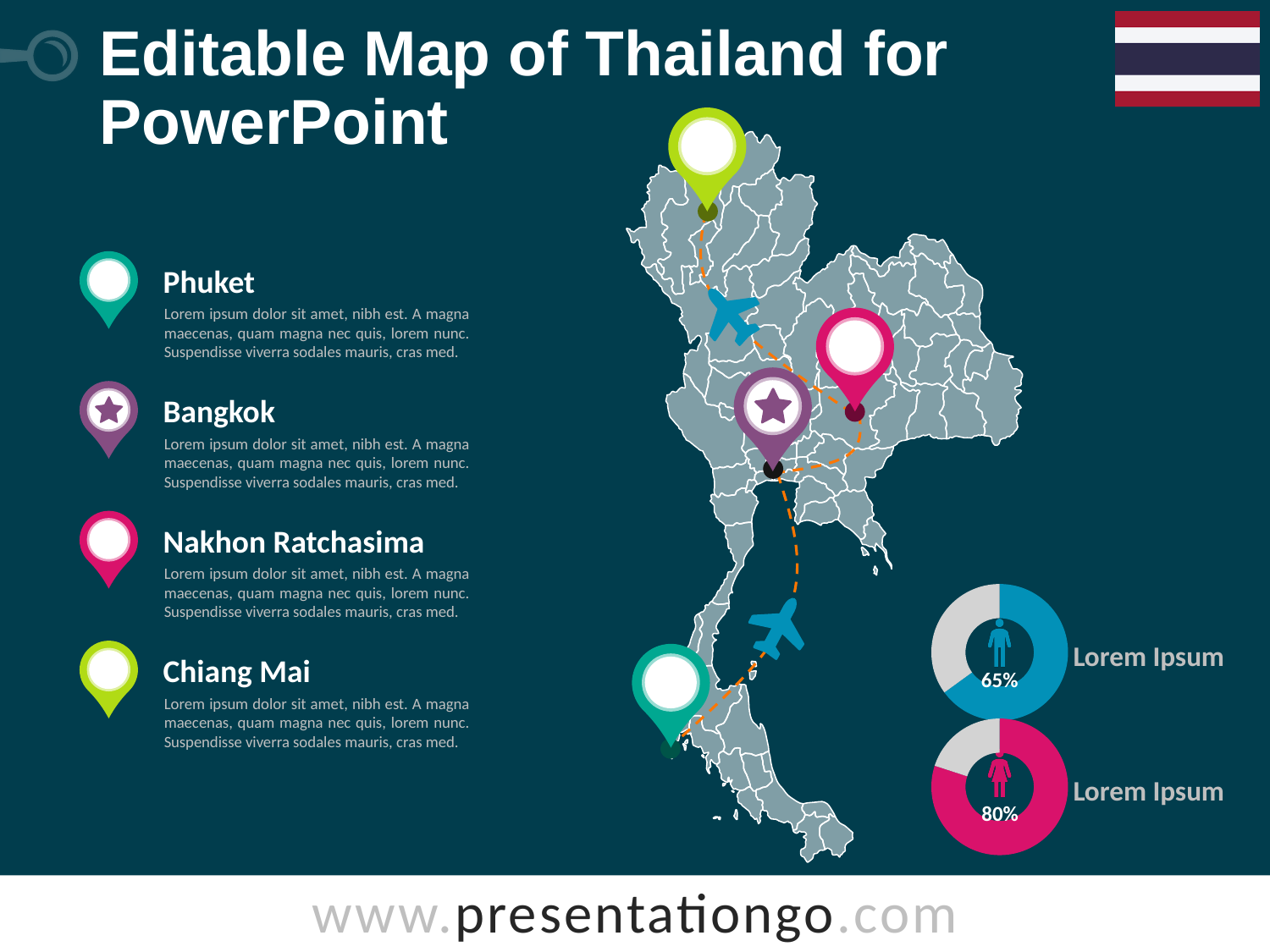
Which donut chart shows the larger value, the upper one or the lower one? The lower one What colour is the filled portion of the lower donut chart? Pink What value is shown in the lower donut chart at the bottom right of the slide? 80% What is the difference between the values shown in the lower donut chart and the upper donut chart? 15% What colour is the filled portion of the upper donut chart? Blue How many donut charts are on the slide? 2 What kind of chart is used to display the 65% and 80% values? Donut chart Is the value in the upper donut chart greater or less than 50%? greater What value is shown in the upper donut chart at the bottom right of the slide? 65% Is the value in the lower donut chart greater or less than 75%? greater What share of the lower donut chart is not filled by the pink segment? 20%